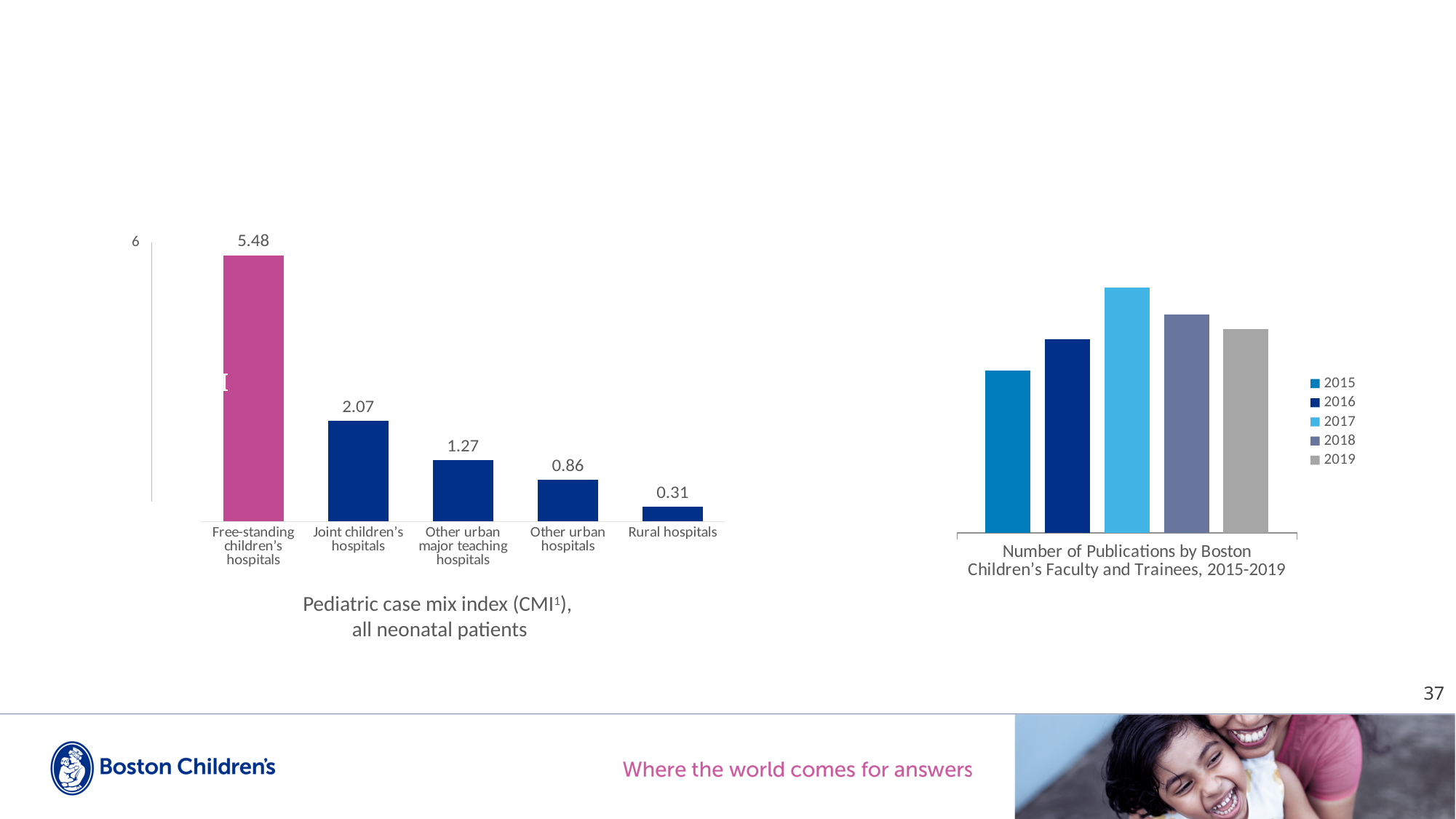
In the Pediatric case mix index chart, which category has the lowest value? Rural hospitals In the Pediatric case mix index chart, how many categories are shown? 5 In the Number of Publications chart, which is larger, the bar for 2016 or the bar for 2018? 2018 In the Number of Publications chart, how many entries does the legend list? 5 In the Pediatric case mix index chart, do the values rise or fall from left to right? fall In the Number of Publications chart, which year has the highest bar? 2017 In the Pediatric case mix index chart, what is the difference between Joint children's hospitals and Other urban hospitals? 1.21 In the Pediatric case mix index chart, which category has the highest value? Free-standing children's hospitals In the Pediatric case mix index chart, what is the value for Rural hospitals? 0.31 In the Number of Publications chart, which year has the lowest bar? 2015 In the Pediatric case mix index chart, what is the value for Other urban major teaching hospitals? 1.27 In the Pediatric case mix index chart, what is the value for Free-standing children's hospitals? 5.48